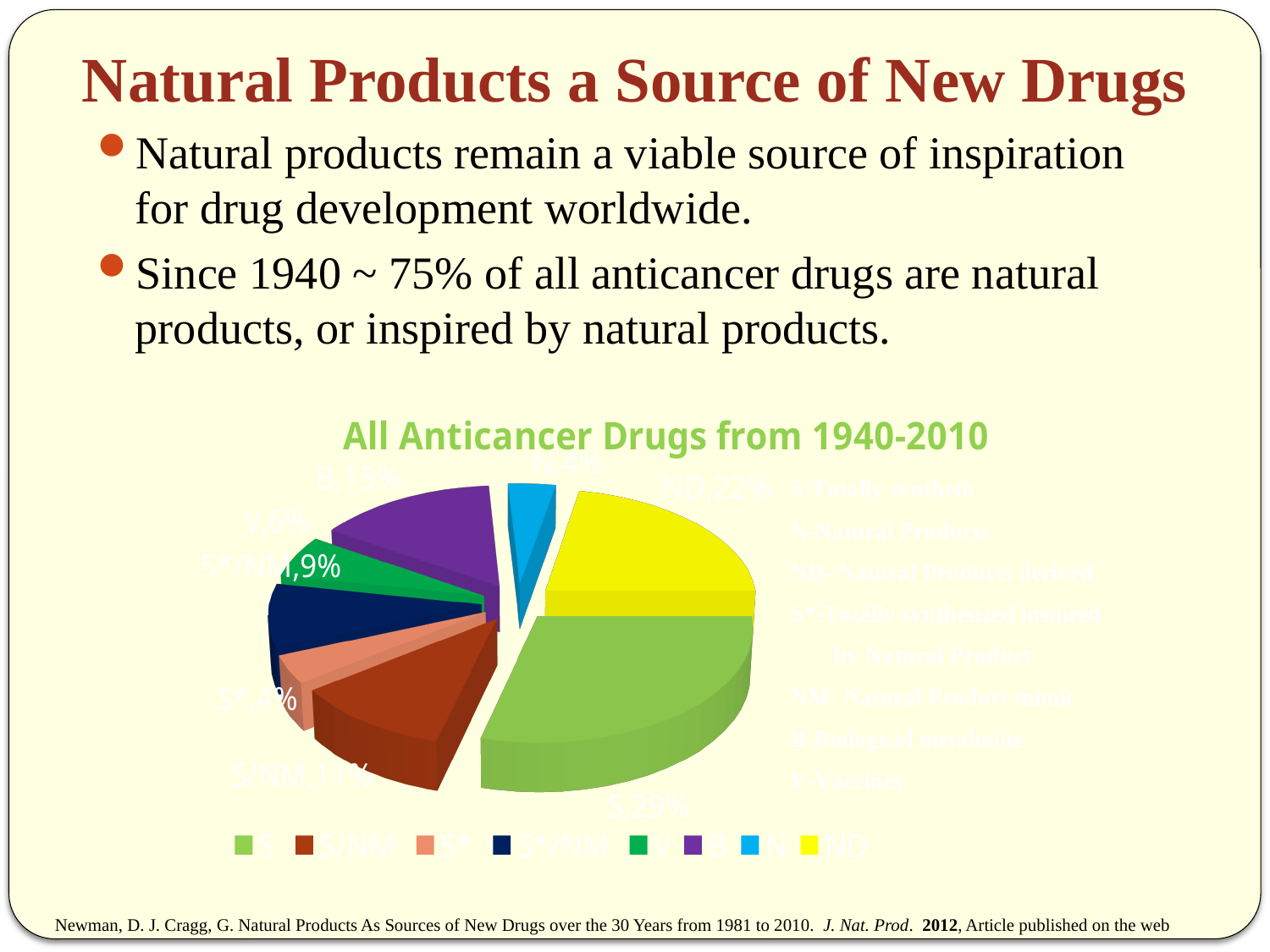
Which category has the largest slice of the pie? S What share of the pie does the V slice represent? 6% How many categories does the legend of the pie chart list? 8 Which slice is larger, B or S/NM? B What share of the pie does the B slice represent? 15% What share of the pie does the S/NM slice represent? 11% What kind of chart is shown on the slide? pie chart What is the difference between the S slice and the ND slice? 7% What share of the pie does the ND slice represent? 22% What colour is the S slice in the pie chart? green What is the title of the chart? All Anticancer Drugs from 1940-2010 What share of the pie does the S slice represent? 29%